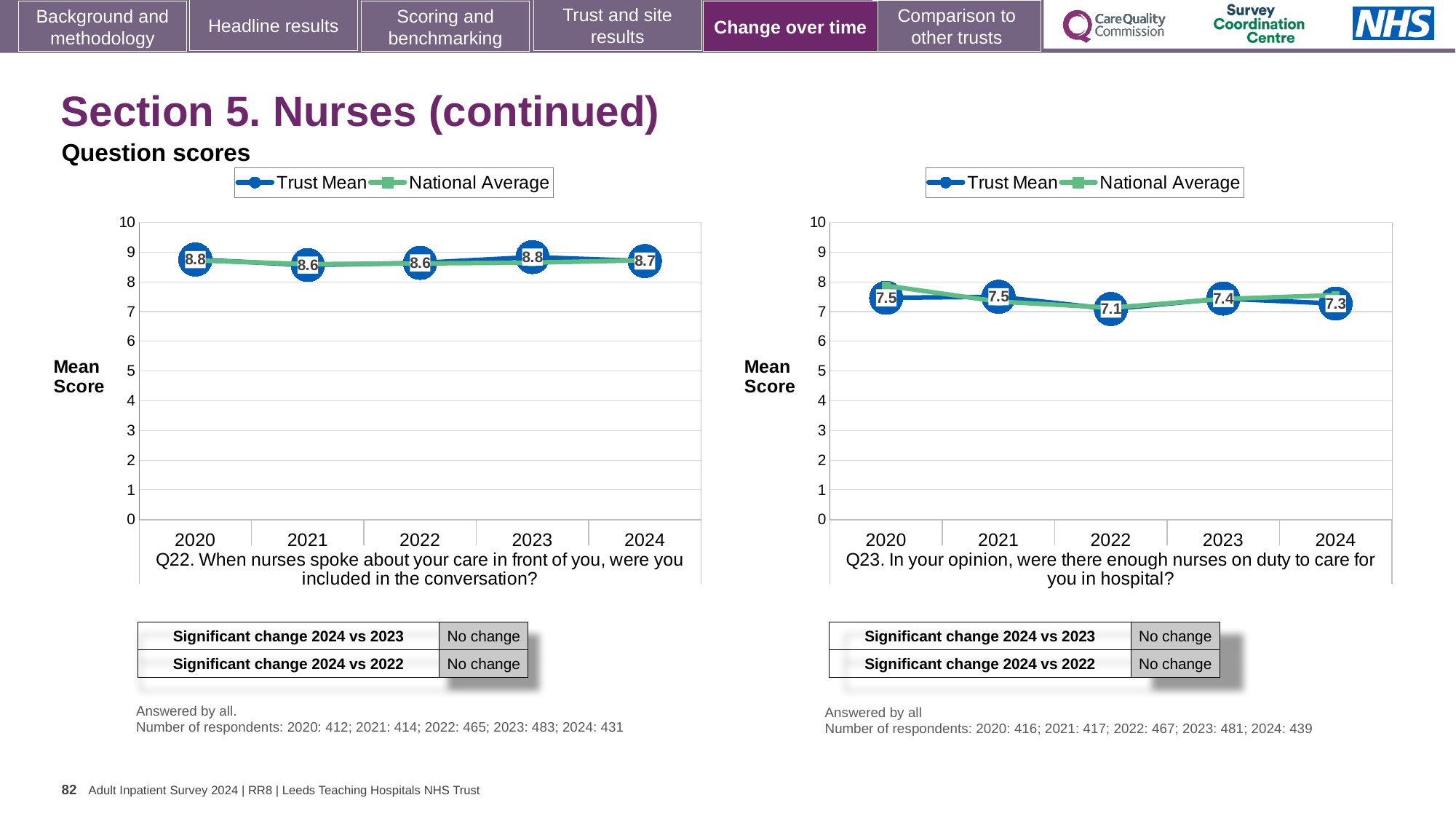
On the Q22 chart (left), is the National Average value for 2020 greater or less than 8? greater On the Q22 chart (left), what is the Trust Mean score for 2020? 8.8 On the Q23 chart (right), which year has the higher Trust Mean score, 2022 or 2023? 2023 On the Q22 chart (left), what is the difference between the Trust Mean scores for 2020 and 2021? 0.2 How many series does the legend of the Q23 chart (right) list? 2 On the Q23 chart (right), which year has the lowest Trust Mean score? 2022 On the Q23 chart (right), what is the Trust Mean score for 2022? 7.1 On the Q23 chart (right), what is the Trust Mean score for 2024? 7.3 How many years are plotted on the Q22 chart (left)? 5 On the Q23 chart (right), what is the difference between the Trust Mean scores for 2021 and 2022? 0.4 What kind of chart is the Q22 chart (left)? Line chart On the Q22 chart (left), what is the Trust Mean score for 2024? 8.7